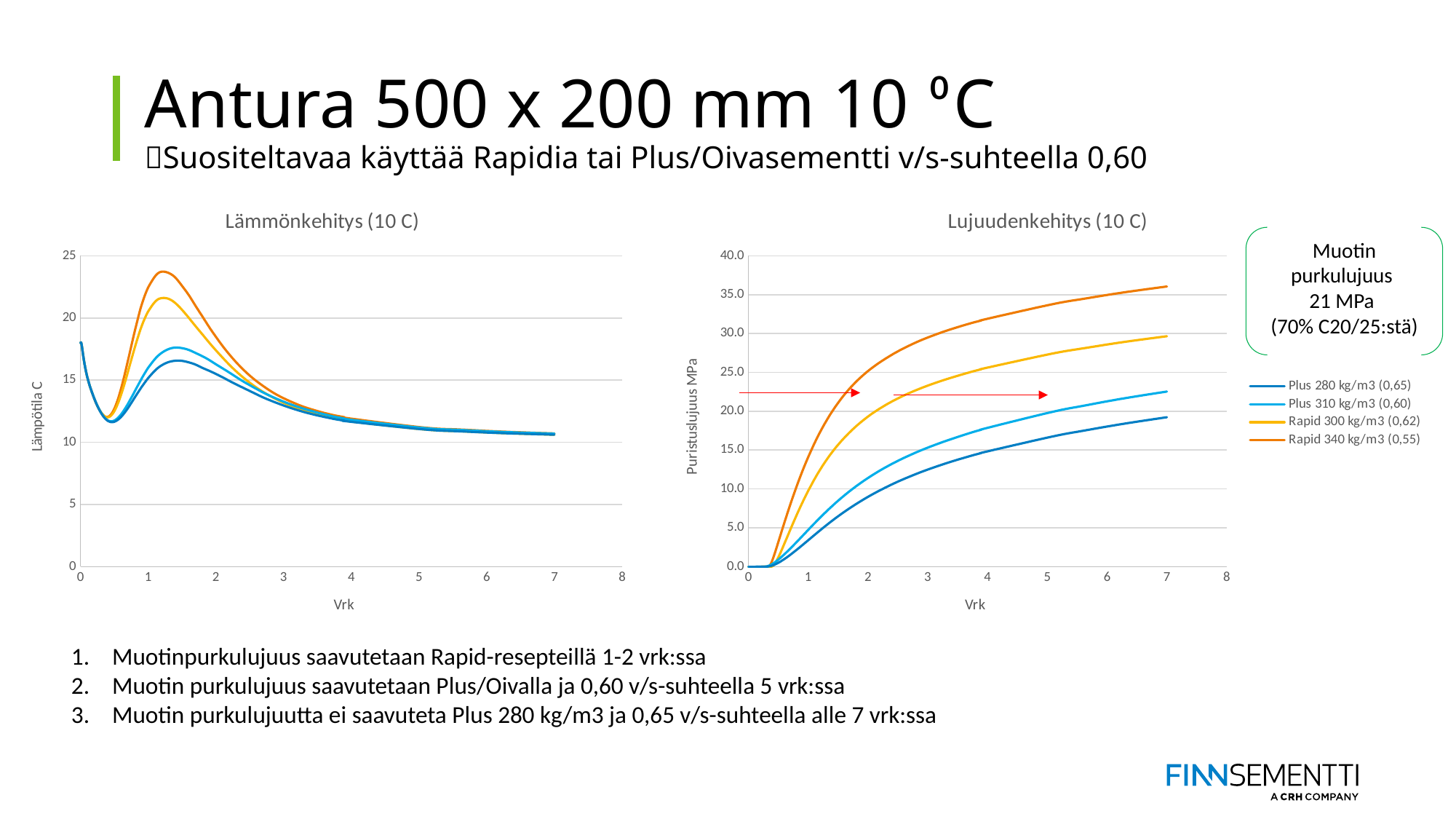
What kind of chart is the 'Lujuudenkehitys (10 C)' chart? line chart In the 'Lujuudenkehitys (10 C)' chart, which series has the highest value at day 7? Rapid 340 kg/m3 (0,55) How many series does the legend of the 'Lujuudenkehitys (10 C)' chart list? 4 In the 'Lujuudenkehitys (10 C)' chart, is the value for Plus 310 kg/m3 (0,60) at day 7 greater or less than 20.0? greater In the 'Lujuudenkehitys (10 C)' chart, is the value for Plus 280 kg/m3 (0,65) at day 7 greater or less than 20.0? less What is the y-axis title of the 'Lämmönkehitys (10 C)' chart? Lämpötila C In the 'Lujuudenkehitys (10 C)' chart, which series has the lowest value at day 7? Plus 280 kg/m3 (0,65) In the 'Lujuudenkehitys (10 C)' chart, do the values rise or fall as the days (Vrk) increase? rise What is the y-axis title of the 'Lujuudenkehitys (10 C)' chart? Puristuslujuus MPa In the 'Lämmönkehitys (10 C)' chart, is the peak value of the highest curve greater or less than 20? greater In the 'Lujuudenkehitys (10 C)' chart, at day 3, which is larger: Rapid 300 kg/m3 (0,62) or Plus 310 kg/m3 (0,60)? Rapid 300 kg/m3 (0,62)